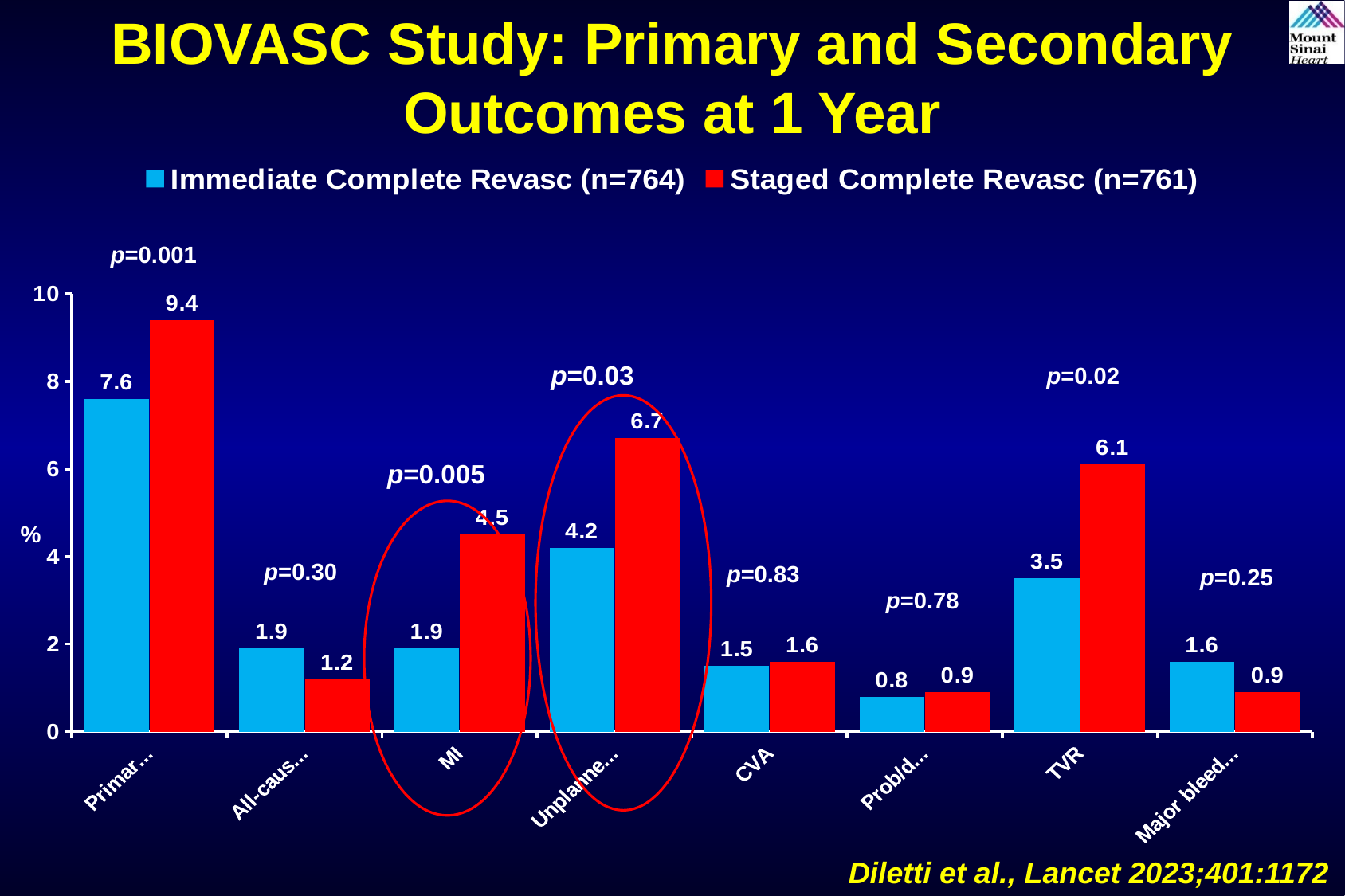
Is the Immediate Complete Revasc value for TVR greater or less than 4? less What type of chart is shown on the slide? bar chart What is the value for TVR in the Immediate Complete Revasc (n=764) series? 3.5 What is the highest value shown for the Staged Complete Revasc (n=761) series? 9.4 How many categories are shown along the x axis? 8 What is the value for CVA in the Staged Complete Revasc (n=761) series? 1.6 For TVR, what is the difference between the Staged Complete Revasc and Immediate Complete Revasc values? 2.6 What p-value is shown above the MI bars? p=0.005 For MI, which series has the larger value, Immediate Complete Revasc or Staged Complete Revasc? Staged Complete Revasc What is the value for MI in the Staged Complete Revasc (n=761) series? 4.5 What is the lowest value shown for the Immediate Complete Revasc (n=764) series? 0.8 How many series does the legend list? 2